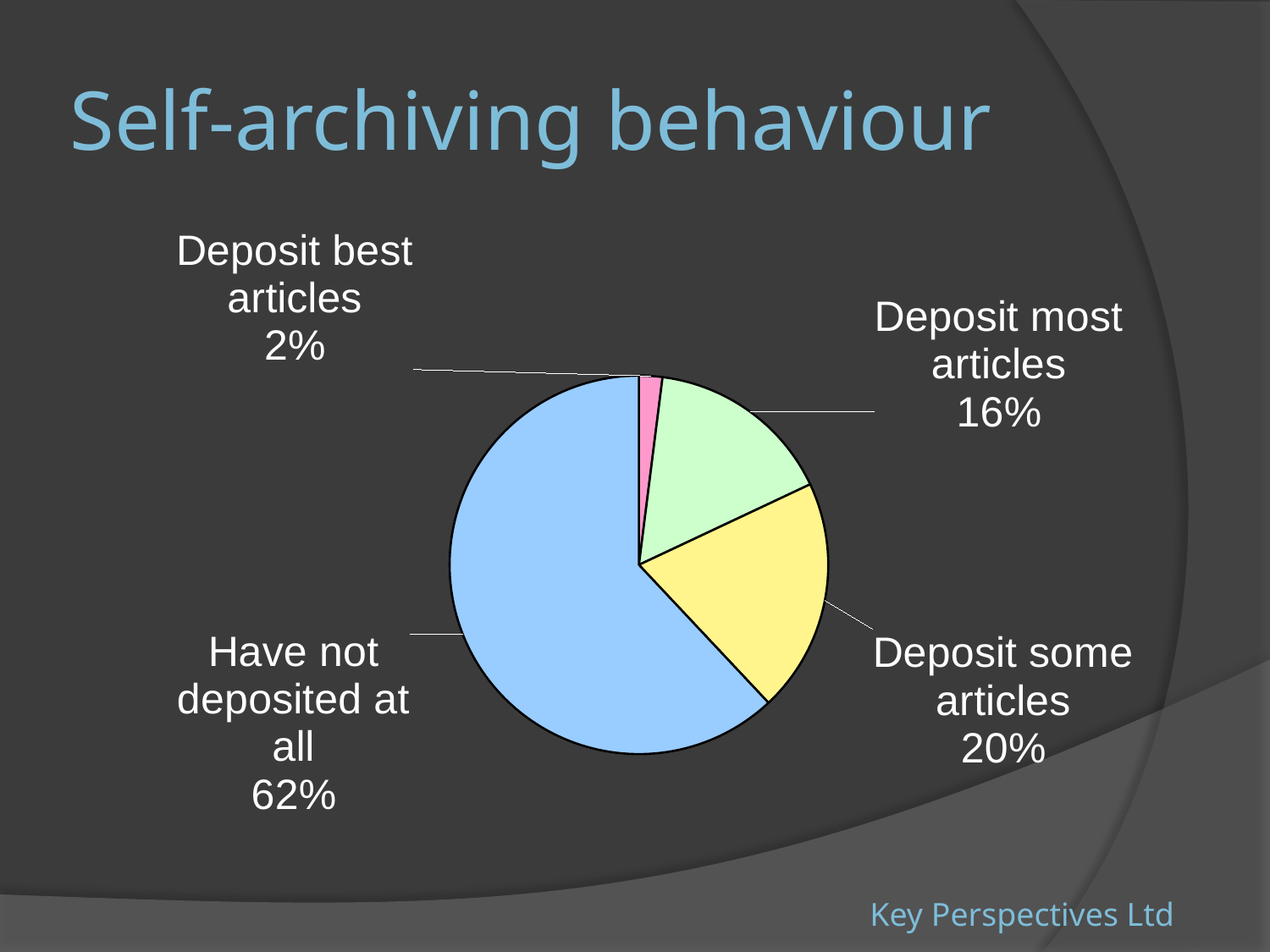
What percentage of respondents have not deposited at all? 62% How many slices does the pie chart have? 4 What kind of chart is shown on the slide? pie chart What is the title of the slide containing the pie chart? Self-archiving behaviour What percentage of respondents deposit most articles? 16% Which is larger: the share for 'Deposit some articles' or 'Deposit most articles'? Deposit some articles What is the difference in percentage points between 'Deposit some articles' and 'Deposit most articles'? 4 What percentage of respondents deposit their best articles? 2% What percentage of respondents deposit some articles? 20% Which category has the largest share of the pie? Have not deposited at all What is the combined percentage of respondents who deposit most, some, or best articles? 38% Which category has the smallest share of the pie? Deposit best articles